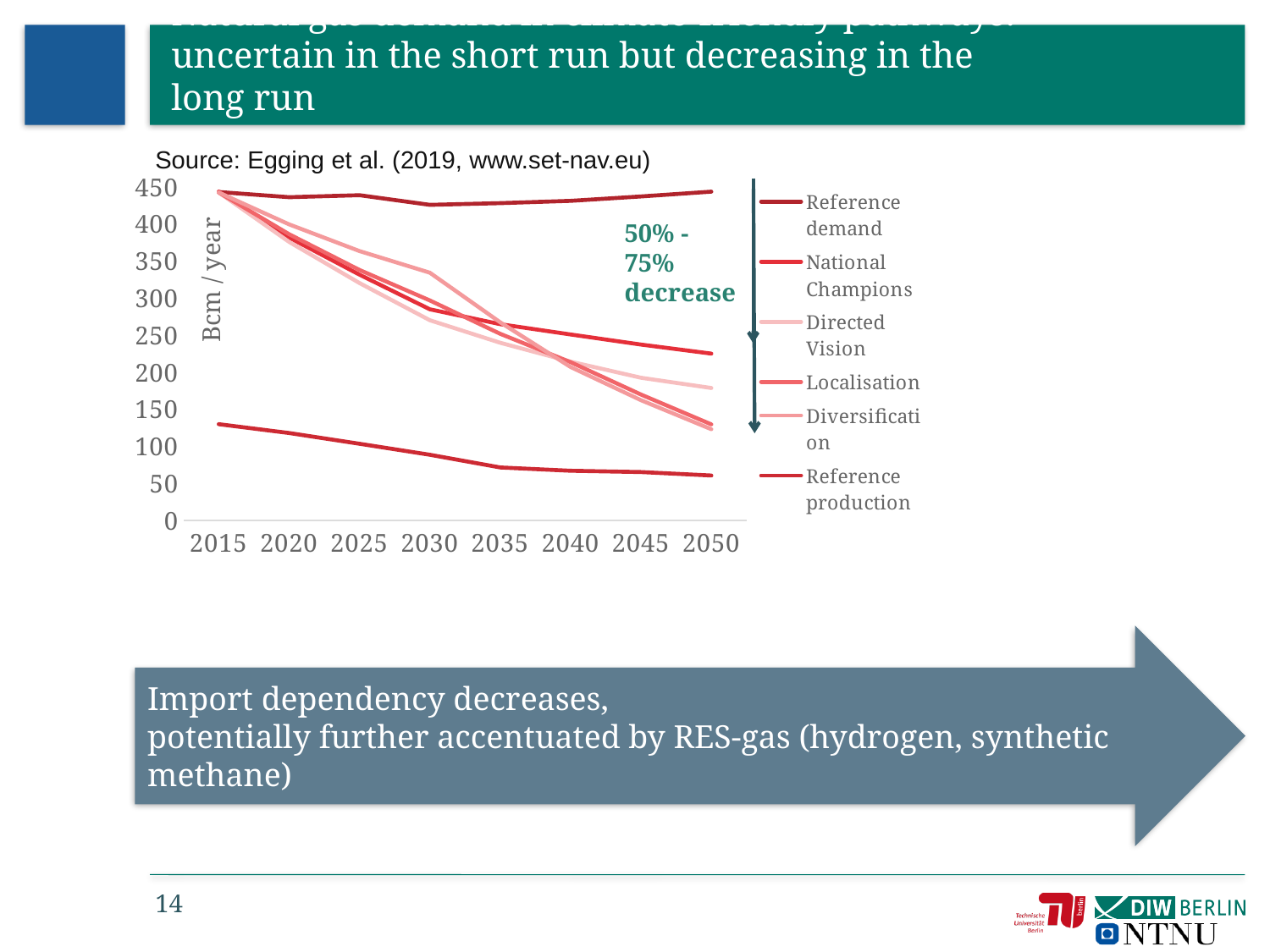
Is the value for Reference demand in 2050 greater or less than 400? greater Is the value for Reference production in 2015 greater or less than 150? less What is the label on the y axis? Bcm / year How many series does the legend list? 6 Does the Reference production line rise or fall from 2015 to 2050? Fall Which series has the highest value in 2050? Reference demand Which series has the lowest value in 2050? Reference production Does the National Champions line rise or fall from 2015 to 2050? Fall Is the value for National Champions in 2050 greater or less than 200? greater How many years are marked along the x axis? 8 What kind of chart is shown on the slide? Line chart